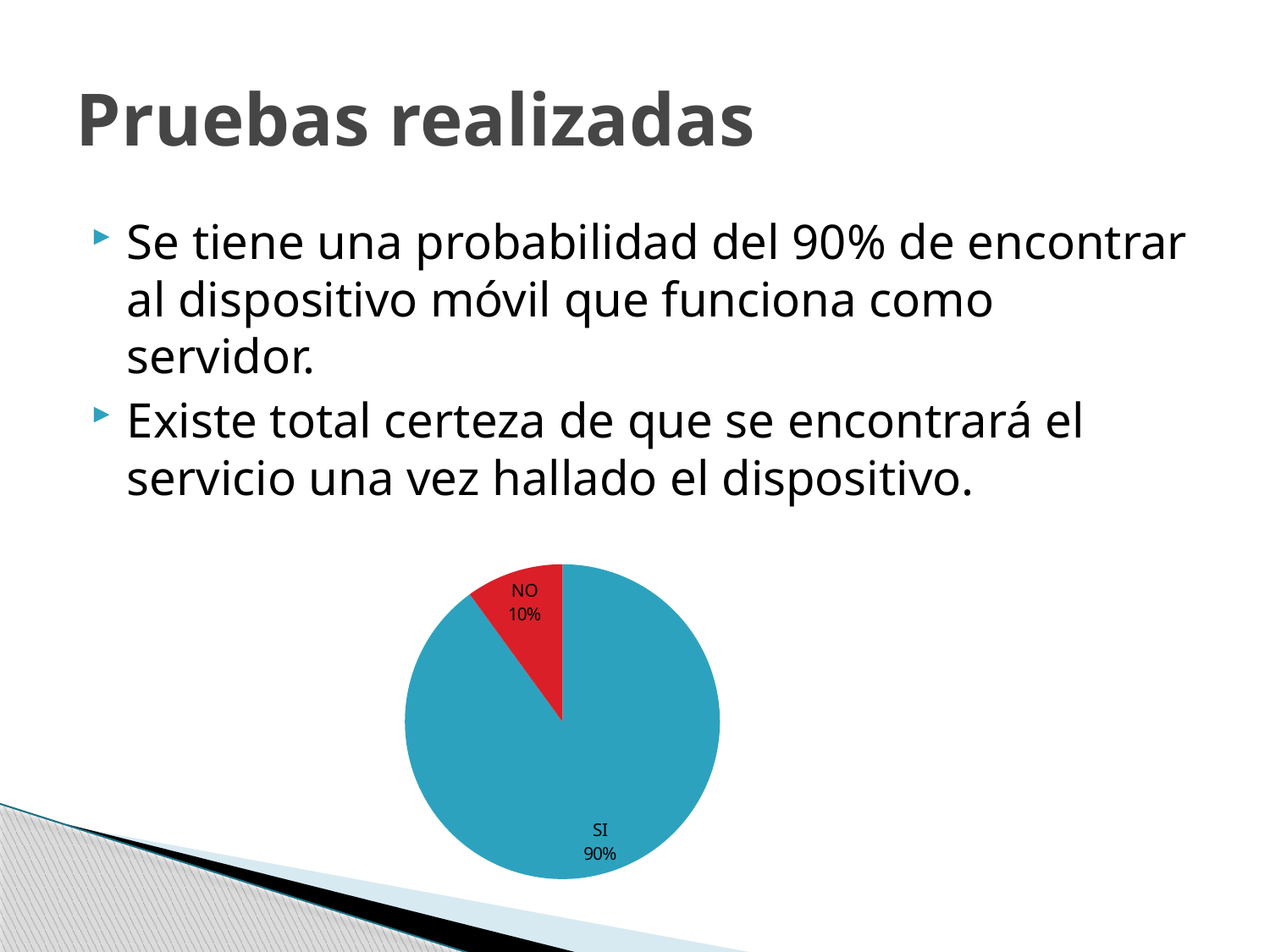
What kind of chart is shown on the slide? pie chart Which slice is larger, SI or NO? SI What colour is the NO slice of the pie chart? red Which slice of the pie chart is the largest? SI What share of the pie does the NO slice represent? 10% What is the difference in percentage points between the SI and NO slices? 80% Which slice of the pie chart is the smallest? NO What share of the pie does the SI slice represent? 90% What colour is the SI slice of the pie chart? blue How many slices does the pie chart have? 2